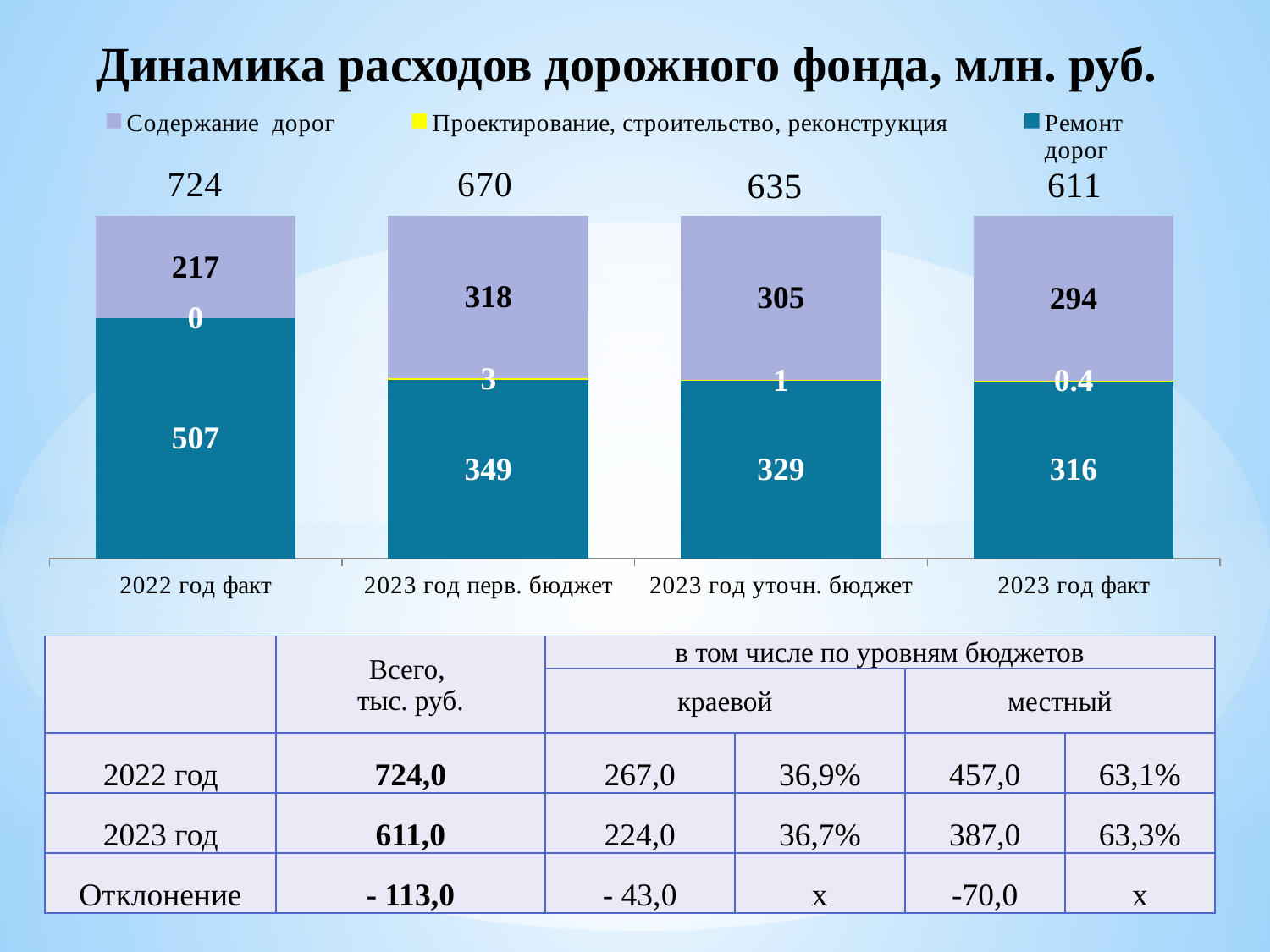
Do the bar totals rise or fall from left to right along the x axis? Fall What is the value of 'Проектирование, строительство, реконструкция' for '2023 год факт'? 0.4 Which category has the highest total? 2022 год факт How many series does the chart legend list? 3 Which is larger: 'Содержание дорог' for '2023 год уточн. бюджет' or for '2023 год факт'? 2023 год уточн. бюджет What is the total of the stacked bar for '2023 год уточн. бюджет'? 635 What is the value of 'Ремонт дорог' for '2022 год факт'? 507 How many categories are shown on the x axis of the chart? 4 What is the value of 'Содержание дорог' for '2023 год перв. бюджет'? 318 What is the difference between the totals for '2022 год факт' and '2023 год факт'? 113 What type of chart is shown on the slide? Stacked bar chart Which category has the lowest value for 'Ремонт дорог'? 2023 год факт